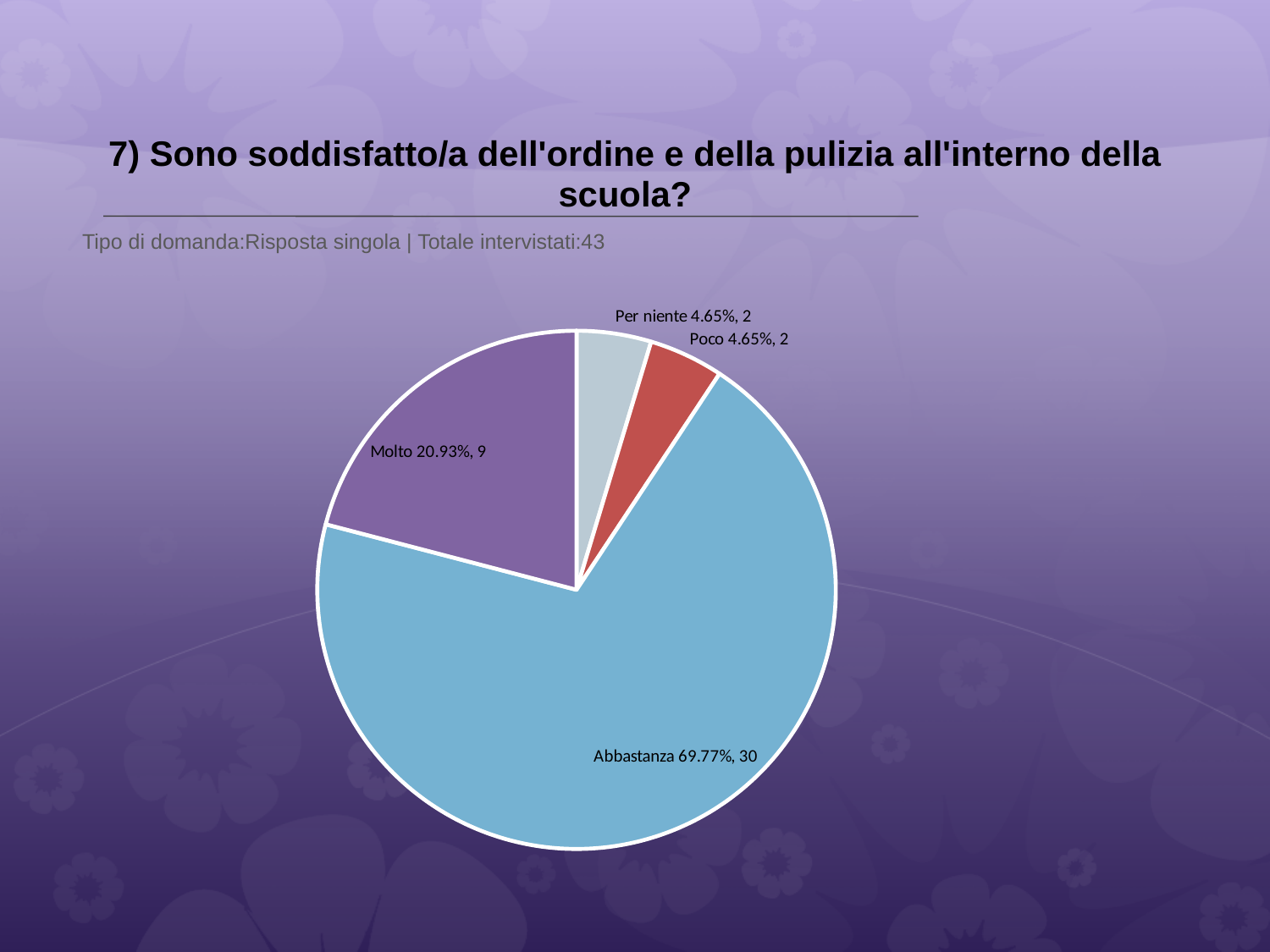
What is the total number of respondents shown on the slide? 43 Which is larger, the 'Molto' slice or the 'Per niente' slice? Molto Which category has the largest slice? Abbastanza How many slices does the pie chart have? 4 How many respondents answered 'Poco'? 2 What kind of chart is shown on the slide? pie chart What is the difference in respondent count between 'Abbastanza' and 'Molto'? 21 What colour is the 'Abbastanza' slice? blue What percentage share does the 'Abbastanza' slice have? 69.77% How many respondents answered 'Molto'? 9 What percentage share does the 'Per niente' slice have? 4.65% What percentage share does the 'Molto' slice have? 20.93%